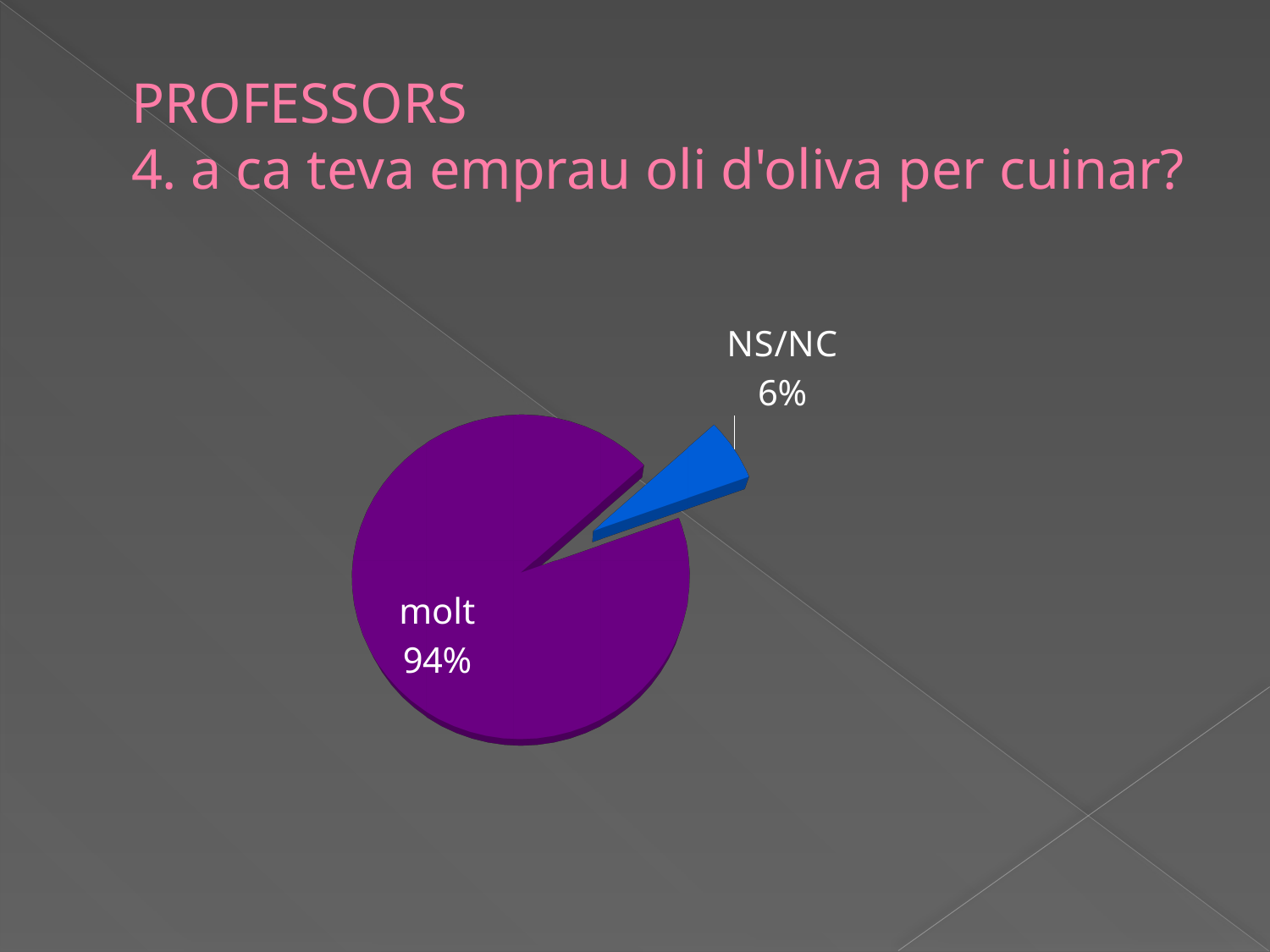
What share of the pie does the "NS/NC" slice represent? 6% What colour is the "NS/NC" slice? blue What colour is the "molt" slice? purple What share of the pie does the "molt" slice represent? 94% Which is larger, the "molt" slice or the "NS/NC" slice? molt Which slice of the pie is the largest? molt How many slices does the pie chart have? 2 What is the difference in percentage points between the "molt" and "NS/NC" slices? 88 Which slice of the pie is the smallest? NS/NC What kind of chart is shown on the slide? pie chart